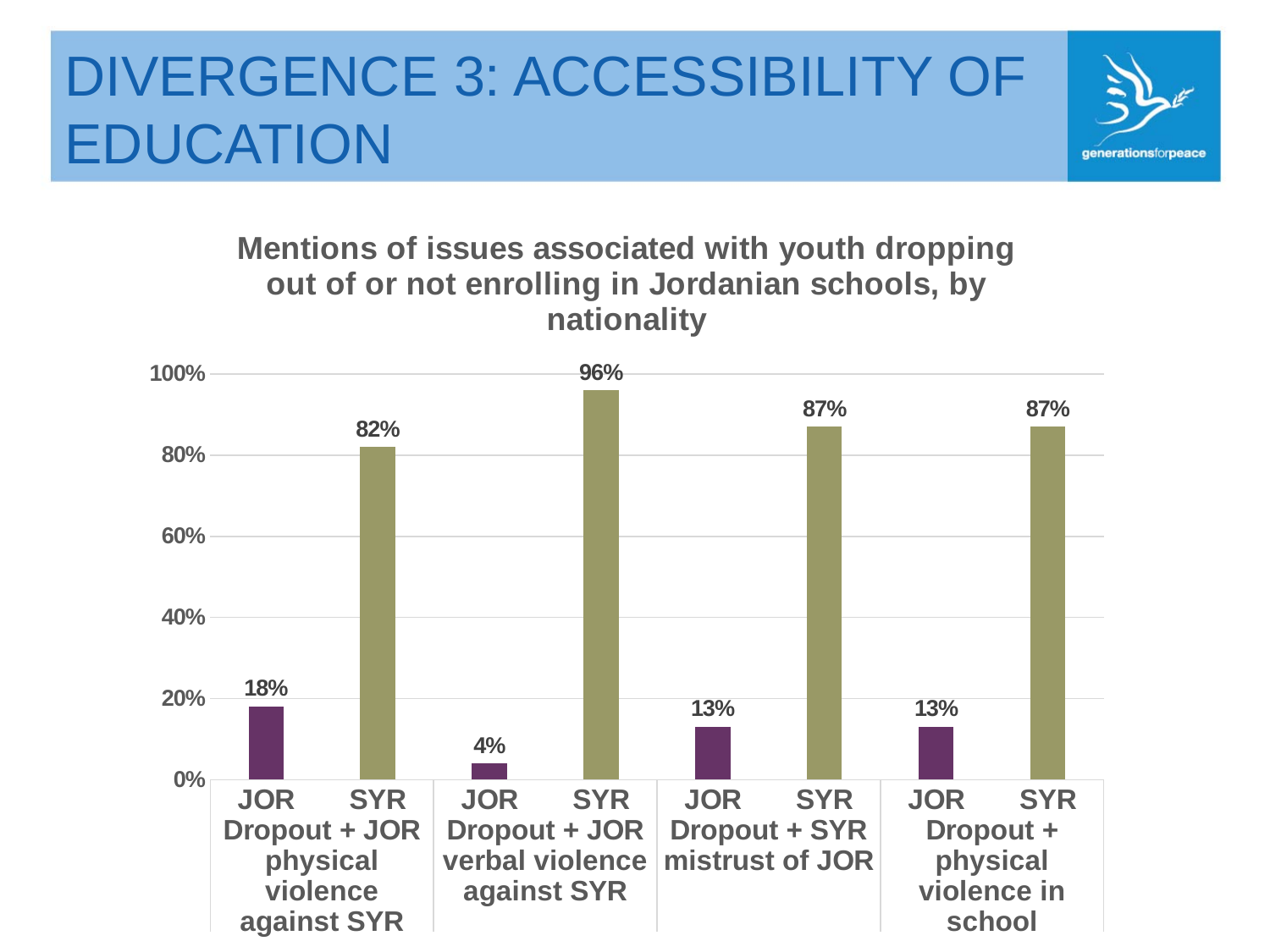
What is the value for JOR in the 'Dropout + SYR mistrust of JOR' group? 13% Which bar has the lowest value on the chart? JOR, Dropout + JOR verbal violence against SYR (4%) What is the value for SYR in the 'Dropout + physical violence in school' group? 87% Which bar has the highest value on the chart? SYR, Dropout + JOR verbal violence against SYR (96%) In the 'Dropout + SYR mistrust of JOR' group, which is larger, the JOR value or the SYR value? SYR What is the difference between the SYR and JOR values in the 'Dropout + JOR physical violence against SYR' group? 64% What is the value for SYR in the 'Dropout + JOR verbal violence against SYR' group? 96% What is the value for JOR in the 'Dropout + JOR physical violence against SYR' group? 18% How many bars are plotted on the chart? 8 What is the difference between the SYR and JOR values in the 'Dropout + JOR verbal violence against SYR' group? 92% What kind of chart is shown on the slide? Bar chart What is the title of the chart? Mentions of issues associated with youth dropping out of or not enrolling in Jordanian schools, by nationality